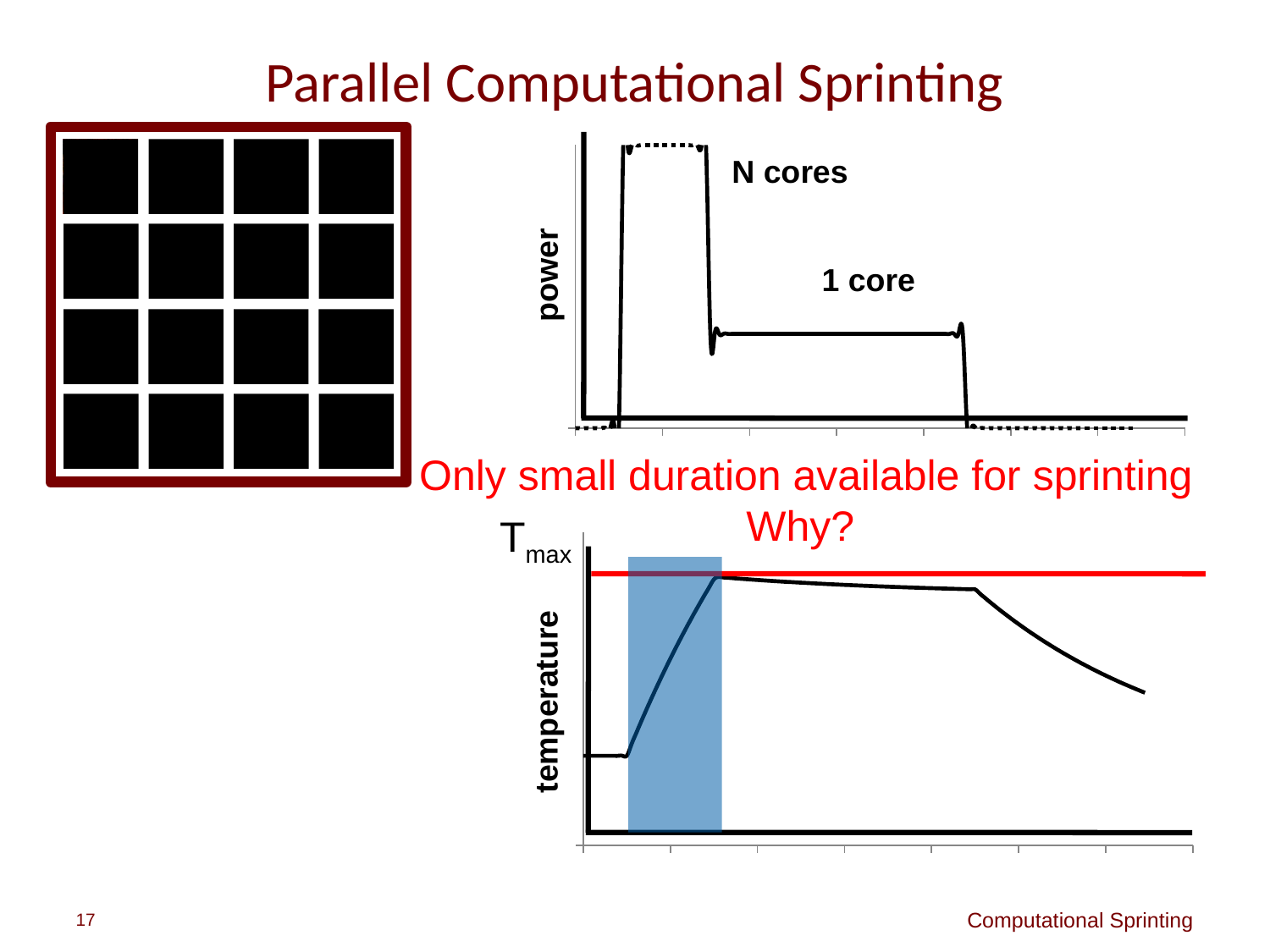
In the bottom temperature chart, does the temperature rise or fall over the right-hand portion of the curve after the plateau? fall What kind of chart is the bottom chart labelled 'temperature'? line chart In the top power chart, does the power rise or fall when the system switches from the 'N cores' phase to the '1 core' phase? fall What kind of chart is the top chart labelled 'power'? line chart What does the red horizontal line in the bottom temperature chart represent? Tmax In the bottom temperature chart, is the temperature at the start of the curve higher or lower than the red Tmax line? lower In the top power chart, does the power rise or fall at the end of the '1 core' phase? fall In the top power chart, which phase has the higher power level, 'N cores' or '1 core'? N cores What is the label on the vertical axis of the top chart? power